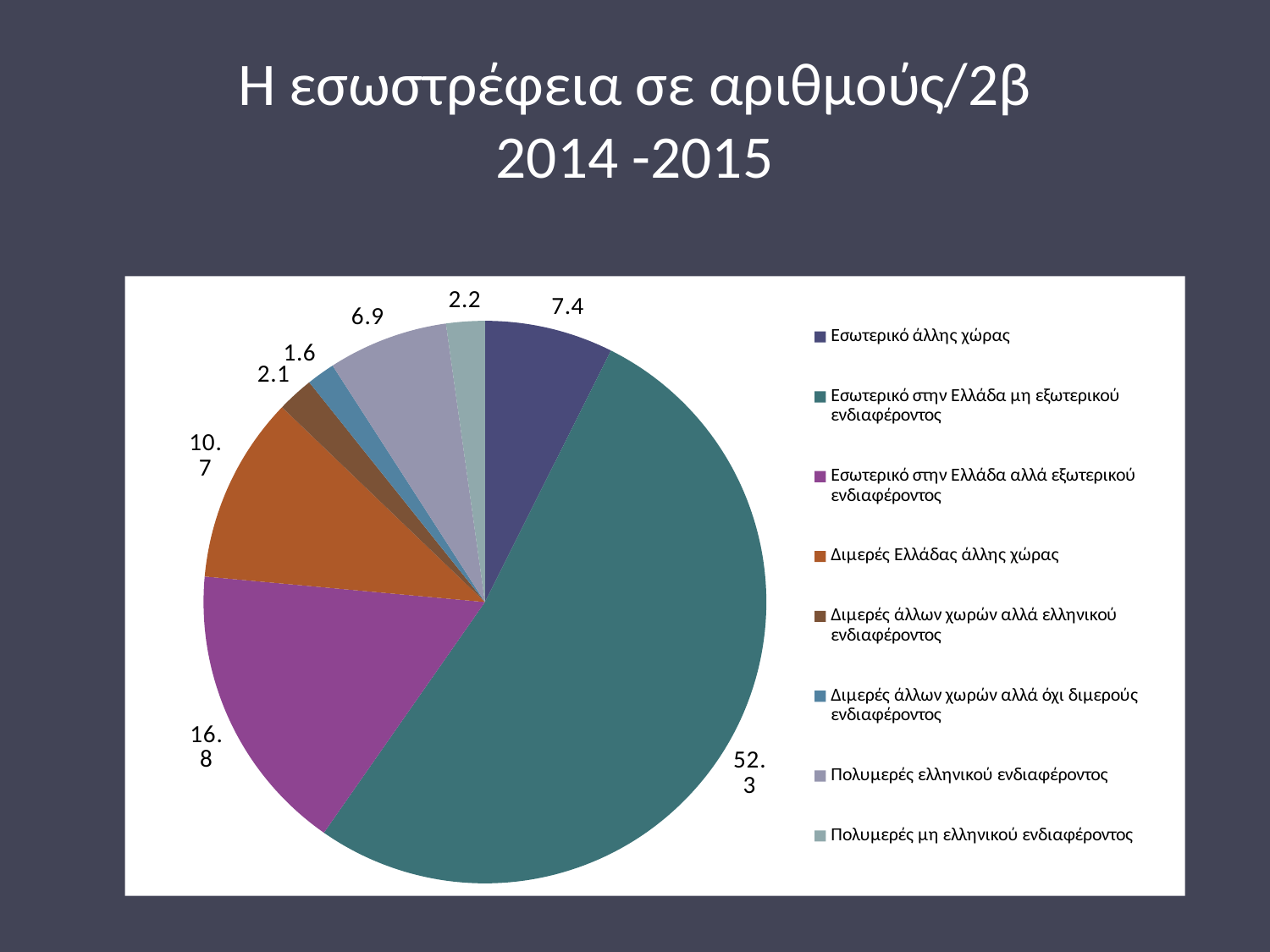
How many slices does the pie chart have? 8 What period is given in the slide title? 2014 -2015 Which is larger, the value for Πολυμερές μη ελληνικού ενδιαφέροντος or the value for Διμερές άλλων χωρών αλλά ελληνικού ενδιαφέροντος? Πολυμερές μη ελληνικού ενδιαφέροντος Which category has the largest slice of the pie? Εσωτερικό στην Ελλάδα μη εξωτερικού ενδιαφέροντος What is the difference between the values for Εσωτερικό άλλης χώρας and Πολυμερές ελληνικού ενδιαφέροντος? 0.5 What is the value for Εσωτερικό άλλης χώρας? 7.4 What is the difference between the values for Εσωτερικό στην Ελλάδα αλλά εξωτερικού ενδιαφέροντος and Διμερές Ελλάδας άλλης χώρας? 6.1 What is the value for Πολυμερές ελληνικού ενδιαφέροντος? 6.9 What kind of chart is shown on the slide? Pie chart Which category has the smallest slice of the pie? Διμερές άλλων χωρών αλλά όχι διμερούς ενδιαφέροντος What is the value for Εσωτερικό στην Ελλάδα μη εξωτερικού ενδιαφέροντος? 52.3 What is the value for Διμερές Ελλάδας άλλης χώρας? 10.7